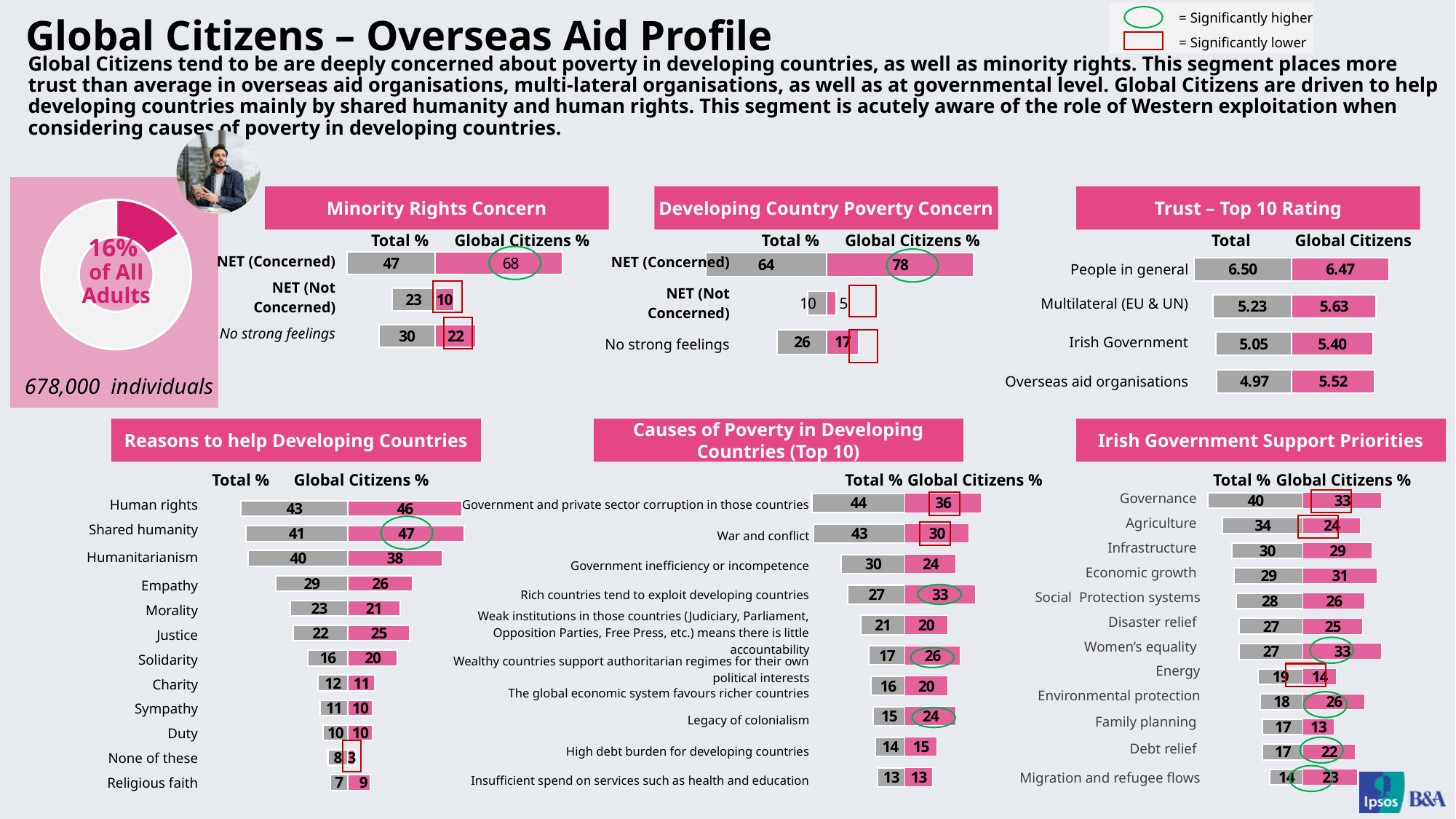
In the Irish Government Support Priorities chart, what is the Global Citizens % for Energy? 14 In the Reasons to help Developing Countries chart, what is the difference between the Total % and Global Citizens % for Shared humanity? 6 In the Irish Government Support Priorities chart, which category has the lowest Total %? Migration and refugee flows In the Reasons to help Developing Countries chart, which reason has the highest Global Citizens %? Shared humanity In the Causes of Poverty in Developing Countries chart, what is the Global Citizens % for Legacy of colonialism? 24 In the Trust – Top 10 Rating chart, which category has the highest Total rating? People in general In the Developing Country Poverty Concern chart, what is the Total % for NET (Concerned)? 64 In the Causes of Poverty in Developing Countries chart, which is larger for Rich countries tend to exploit developing countries: Total % or Global Citizens %? Global Citizens % In the Trust – Top 10 Rating chart, what is the Global Citizens rating for Overseas aid organisations? 5.52 How many reasons are listed in the Reasons to help Developing Countries chart? 12 In the Minority Rights Concern chart, what is the Global Citizens % for NET (Concerned)? 68 What share of all adults does the donut chart on the left show for Global Citizens? 16%